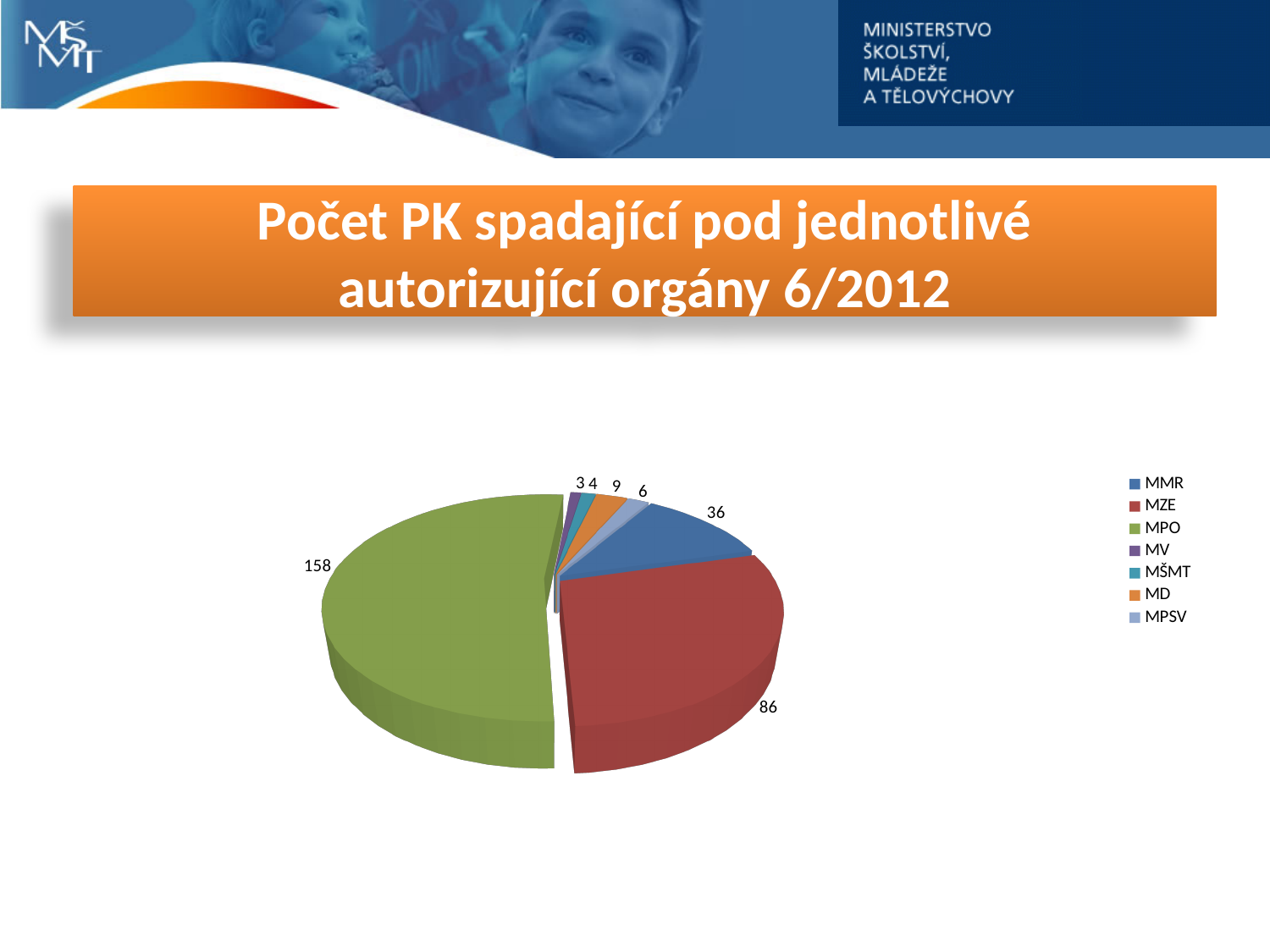
Which authorizing body has the smallest slice of the pie? MV What is the value for MD? 9 Which authorizing body has the largest slice of the pie? MPO How many categories does the pie chart have? 7 What is the title of the slide containing the chart? Počet PK spadající pod jednotlivé autorizující orgány 6/2012 What is the value for MMR? 36 What is the value for MZE? 86 What kind of chart is shown on the slide? pie chart What is the value for MPO? 158 Which colour represents MŠMT in the legend? teal What is the difference between the values for MPO and MZE? 72 Which is larger, the value for MMR or the value for MPSV? MMR